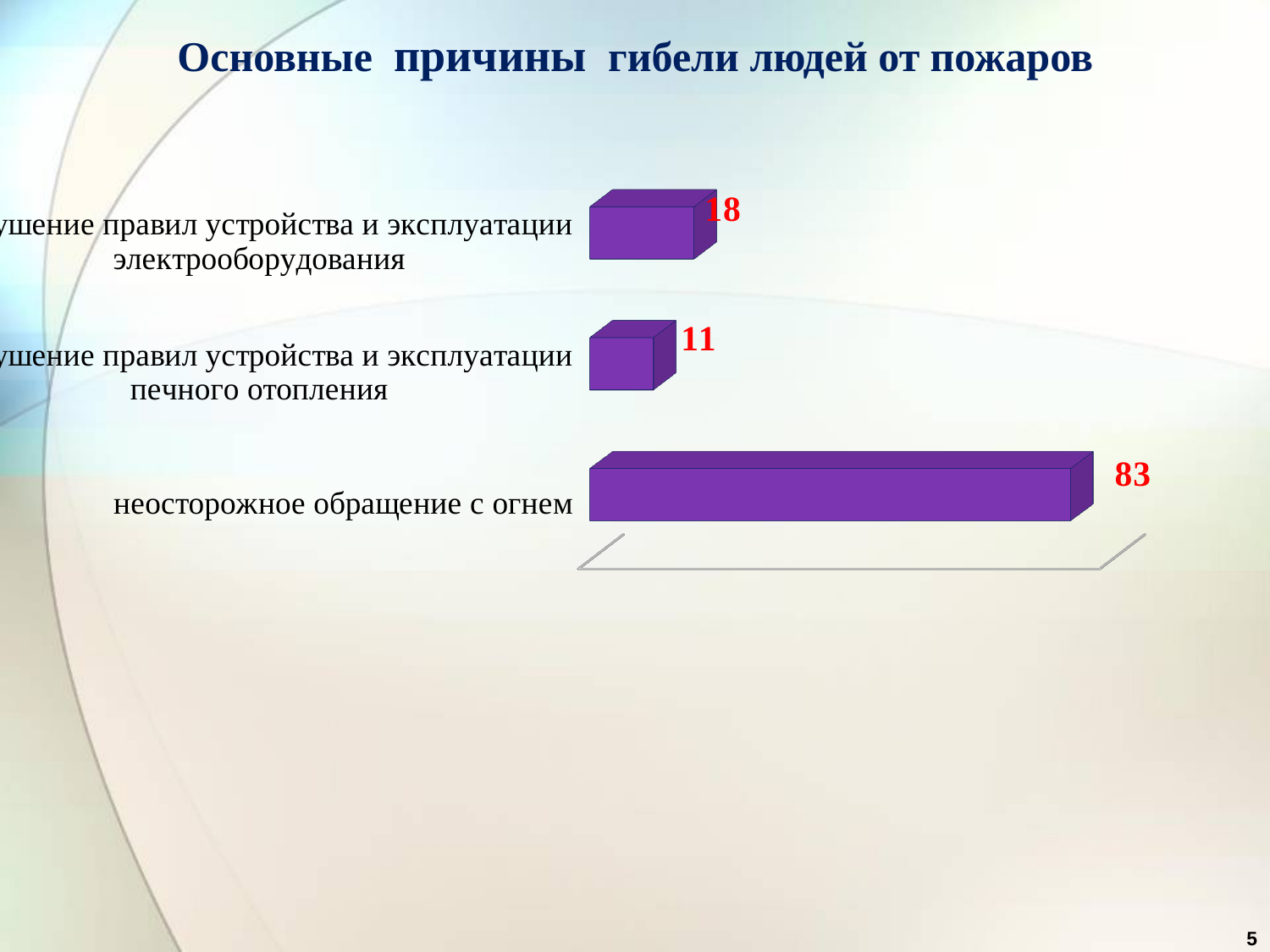
What colour are the bars in the chart? purple What kind of chart is shown on the slide? bar chart What is the value for the category ending in "эксплуатации электрооборудования"? 18 Which category has the lowest value? нарушение правил устройства и эксплуатации печного отопления What is the value for the category "неосторожное обращение с огнем"? 83 What is the title of the slide? Основные причины гибели людей от пожаров Which category has the highest value? неосторожное обращение с огнем What is the difference between the value for the "электрооборудования" category and the value for the "печного отопления" category? 7 Which is larger: the value for the "электрооборудования" category or the value for the "печного отопления" category? электрооборудования How many categories are shown in the chart? 3 What is the difference between the value for "неосторожное обращение с огнем" and the value for the "электрооборудования" category? 65 What is the value for the category ending in "эксплуатации печного отопления"? 11